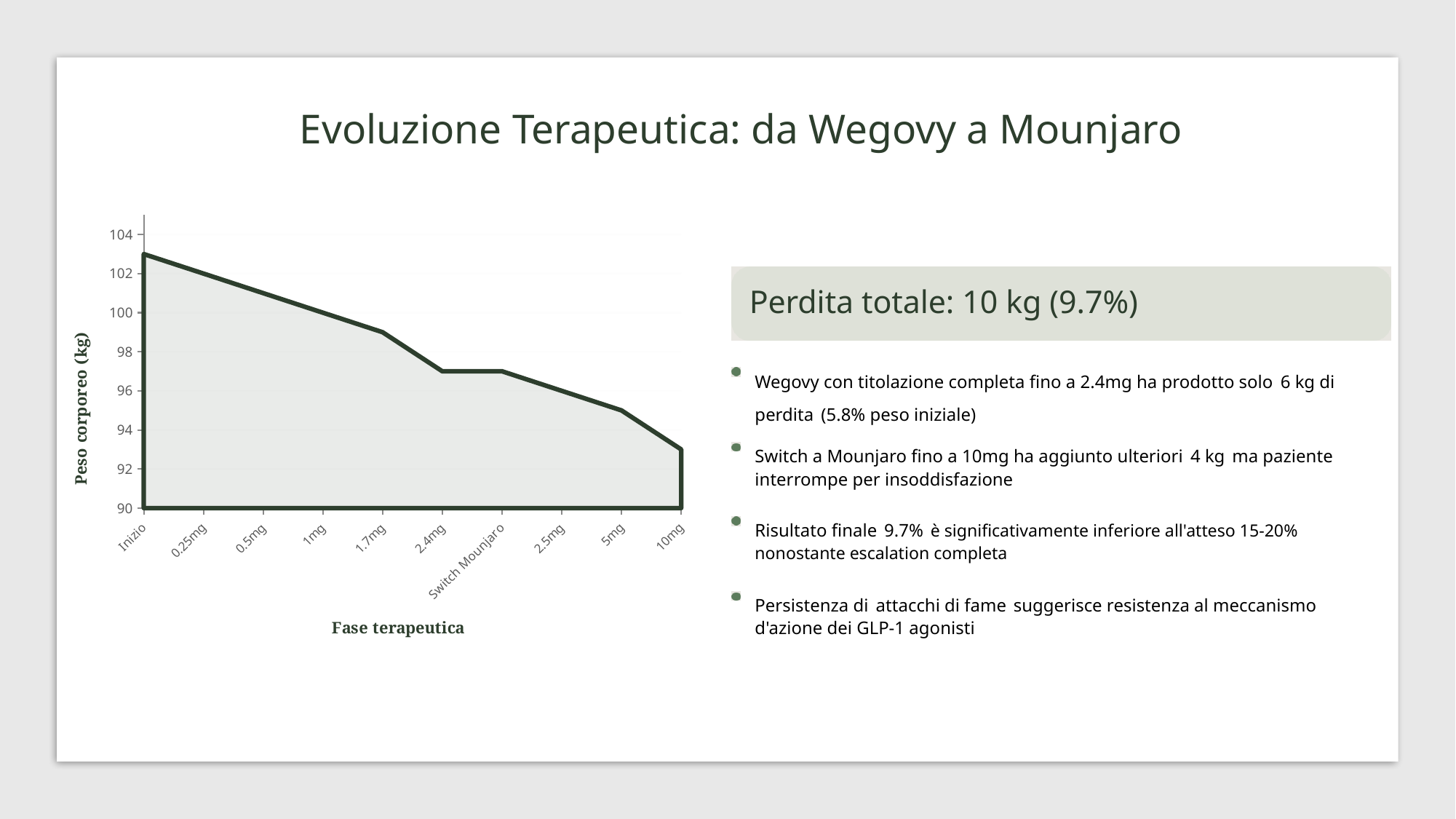
What is the label of the vertical axis of the chart? Peso corporeo (kg) Is the body weight at Inizio greater or less than 102 kg? greater What kind of chart is shown on the slide? area chart Is the body weight at 0.25mg greater or less than 100 kg? greater Is the body weight at 2.4mg greater or less than 98 kg? less Which phase has the highest body weight? Inizio Which phase has the lowest body weight? 10mg How many therapeutic phases are plotted along the x axis? 10 Which is larger, the body weight at 1.7mg or at 5mg? 1.7mg Do the body weight values rise or fall along the x axis from Inizio to 10mg? fall